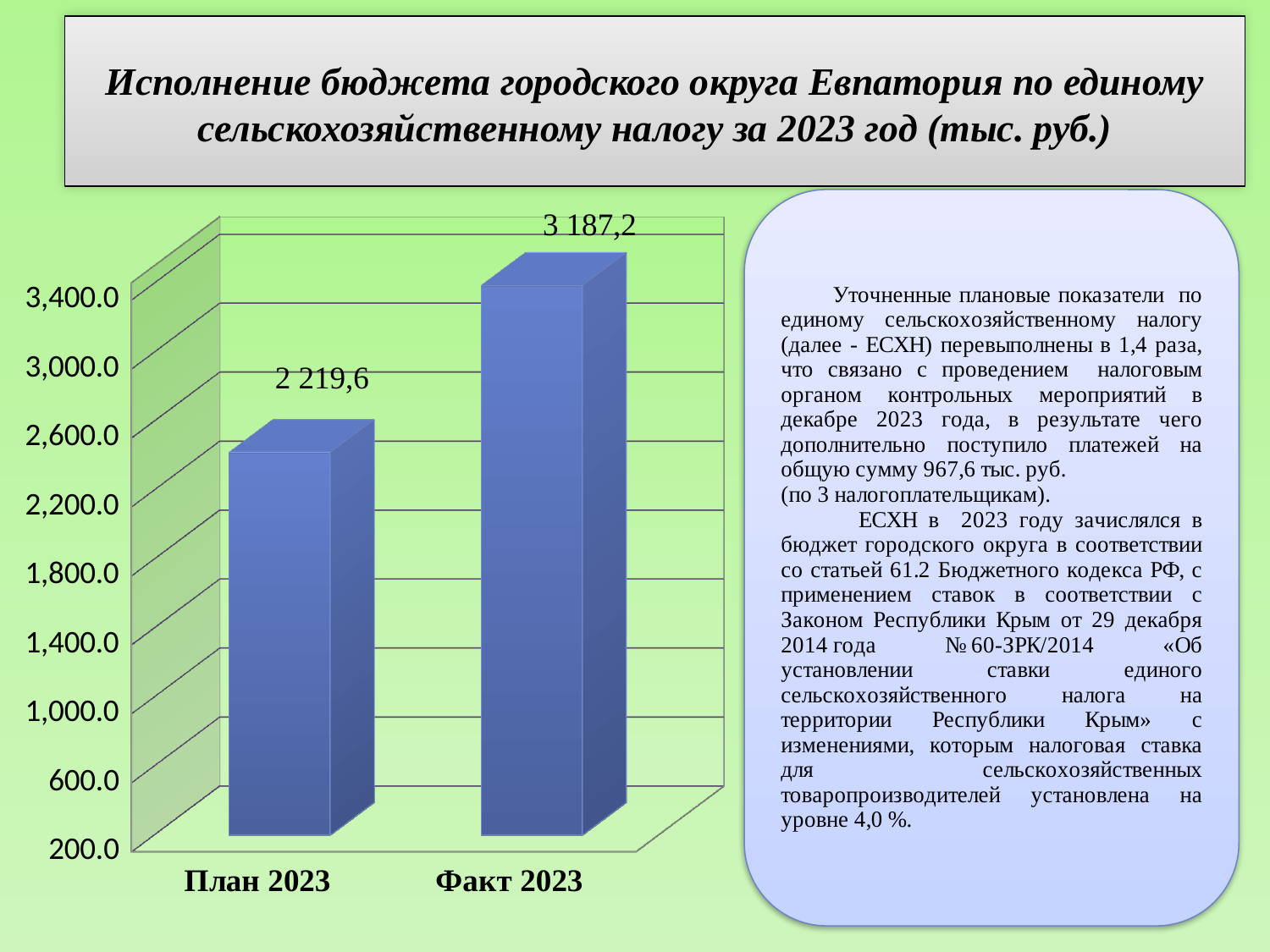
Is the value for Факт 2023 greater or less than 3,000.0? greater What kind of chart is shown on the slide? bar chart Do the values rise or fall from План 2023 to Факт 2023? rise What is the value for Факт 2023? 3 187,2 Which is larger, the value for План 2023 or the value for Факт 2023? Факт 2023 What is the difference between the values for Факт 2023 and План 2023? 967,6 What is the highest tick value shown on the vertical axis? 3,400.0 Which category has the lowest value? План 2023 Which category has the highest value? Факт 2023 Is the value for План 2023 greater or less than 2,600.0? less How many categories are shown on the chart? 2 What is the value for План 2023? 2 219,6